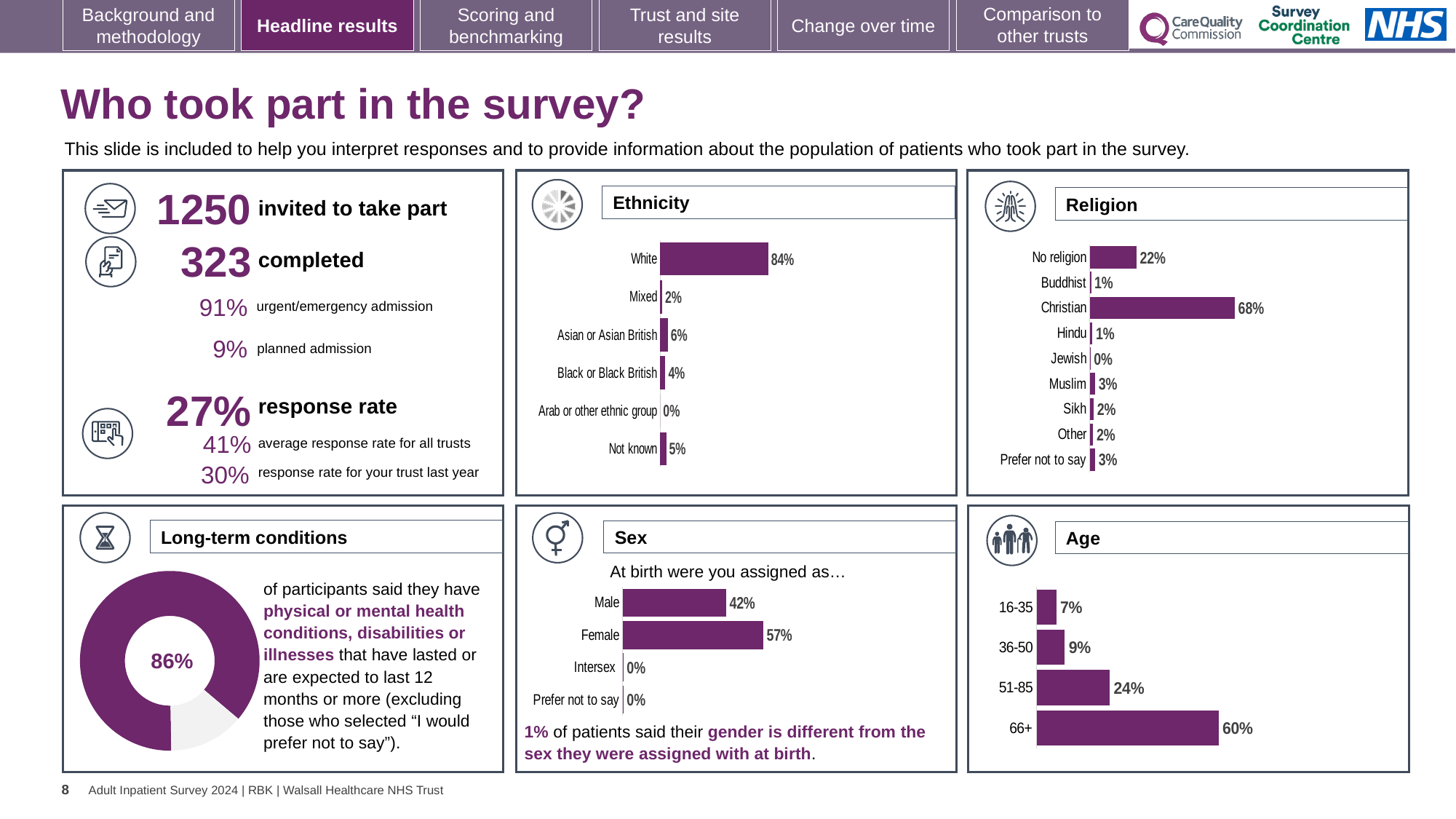
In the Ethnicity chart, what percentage of respondents were White? 84% In the Age chart, which age group has the lowest value? 16-35 In the Religion chart, which religion category has the highest value? Christian In the Ethnicity chart, how many ethnicity categories are shown? 6 In the Age chart, do the values rise or fall as the age groups go from 16-35 to 66+? rise In the Long-term conditions chart, what share of participants said they have long-term conditions? 86% What kind of chart is used in the Ethnicity panel? bar chart In the Sex chart, what is the difference between the Female and Male values? 15% In the Religion chart, what is the value for No religion? 22% In the Religion chart, what is the difference between the Christian and No religion values? 46% In the Age chart, what is the value for the 66+ age group? 60% In the Sex chart, which is larger, the value for Male or the value for Female? Female